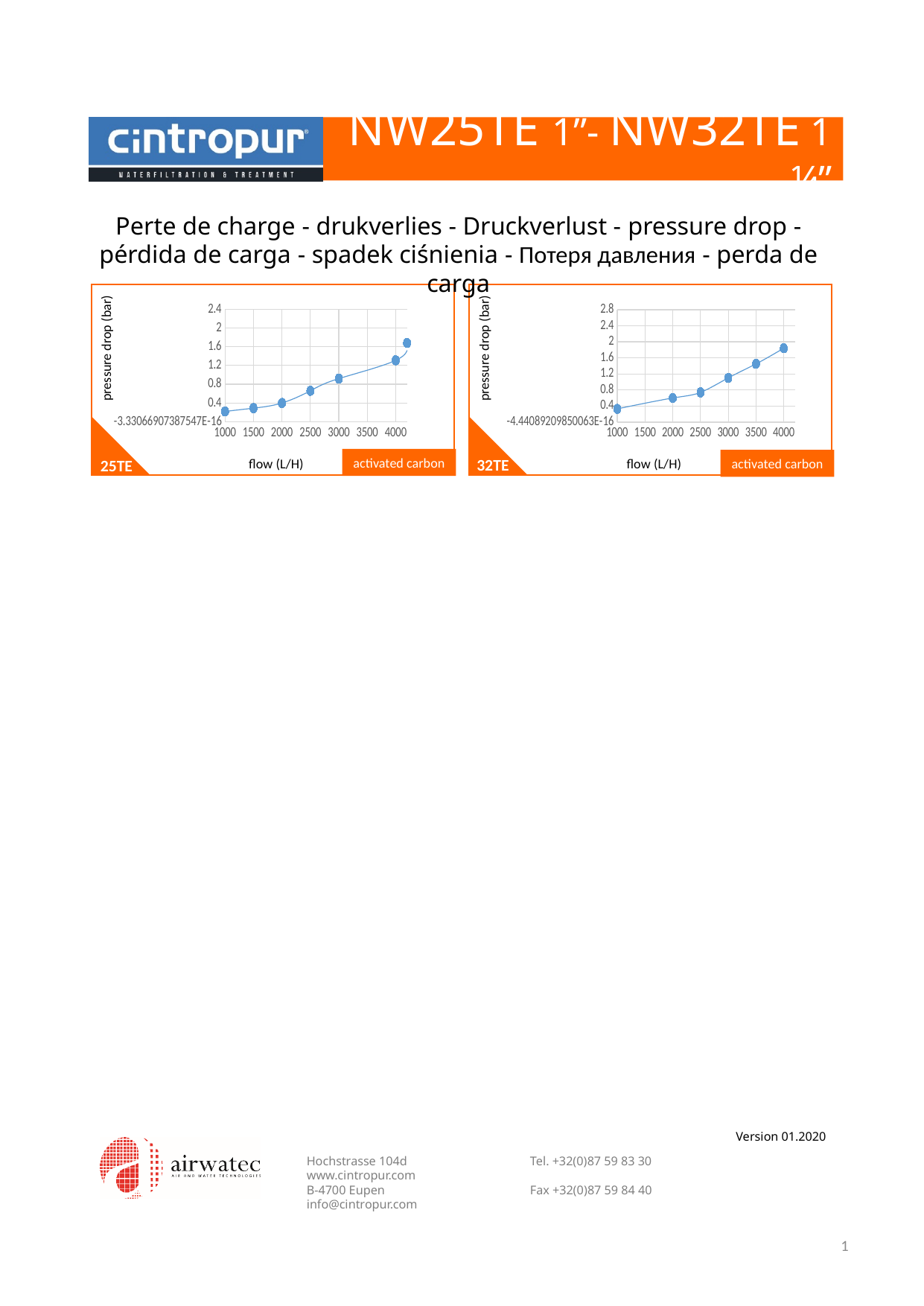
What is the label on the y axis of the 25TE chart on the left? pressure drop (bar) What kind of chart is the 25TE chart on the left? line chart How many data points are plotted in the 25TE chart on the left? 7 What is the label on the x axis of the 32TE chart on the right? flow (L/H) In the 25TE chart on the left, do the pressure drop values rise or fall as flow increases? rise In the 32TE chart on the right, do the pressure drop values rise or fall as flow increases? rise In the 32TE chart on the right, is the pressure drop at a flow of 3000 L/H greater or less than 0.8 bar? greater In the 25TE chart on the left, is the pressure drop at a flow of 1000 L/H greater or less than 0.4 bar? less In the 25TE chart on the left, which has the larger pressure drop: a flow of 1000 L/H or a flow of 4000 L/H? 4000 L/H In the 32TE chart on the right, is the pressure drop at a flow of 4000 L/H greater or less than 2 bar? less How many data points are plotted in the 32TE chart on the right? 6